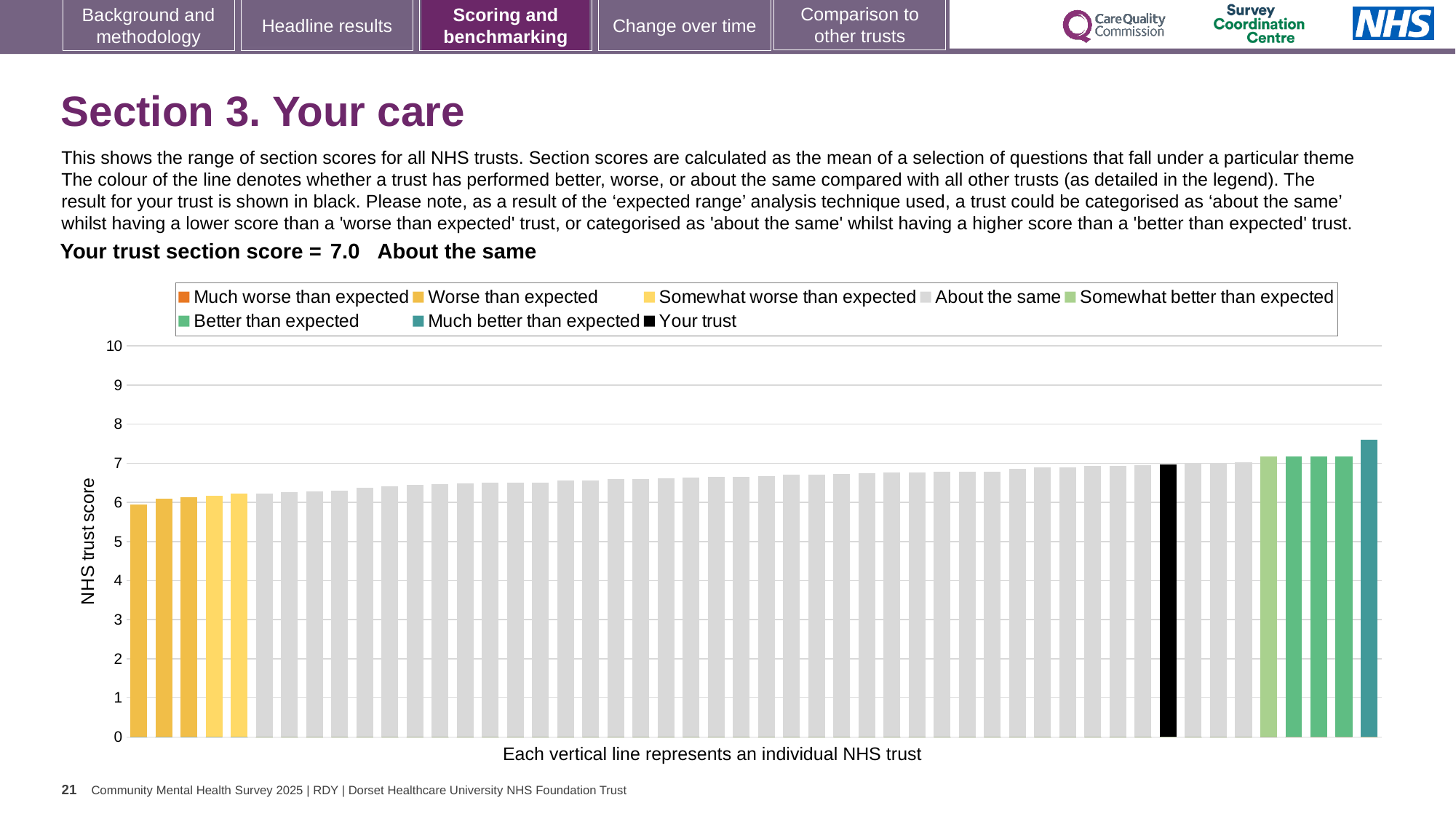
Is the value of the rightmost (tallest) bar greater or less than 7? greater What is the label on the vertical axis of the chart? NHS trust score Do the bar values rise or fall from left to right along the x axis? rise Is the value of the black bar (your trust) greater or less than 5? greater What is the section score for your trust shown on the slide? 7.0 Which category is your trust's section score placed in? About the same Is the value of the tallest bar greater or less than 8? less What is the highest value shown on the vertical axis? 10 What kind of chart is shown on the slide? bar chart How many entries does the chart legend list? 8 What colour is used for the bar representing your trust? black